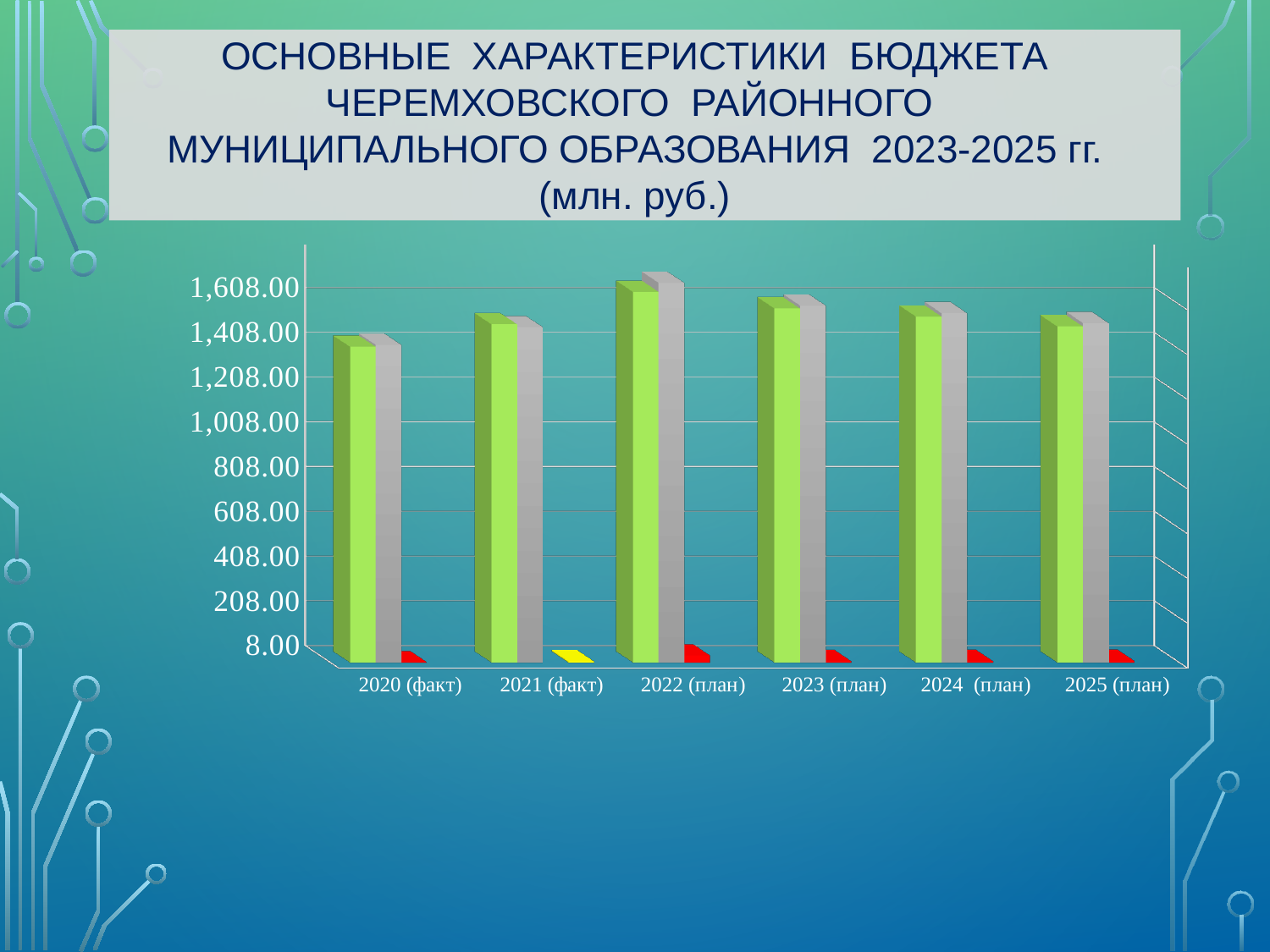
What kind of chart is shown on the slide? bar chart Which category has the shortest green bar? 2020 (факт) Which category has the tallest green bar? 2022 (план) Which green bar is taller: 2021 (факт) or 2023 (план)? 2023 (план) Is the green bar for 2020 (факт) greater or less than 1,208.00? greater From 2022 (план) to 2025 (план), do the green bars rise or fall? fall How many categories (years) are shown on the x axis of the chart? 6 Is the green bar for 2022 (план) greater or less than 1,408.00? greater Is the green bar for 2025 (план) greater or less than 1,208.00? greater What colour is the small bar next to the green bar for 2021 (факт)? yellow Which green bar is taller: 2022 (план) or 2020 (факт)? 2022 (план)